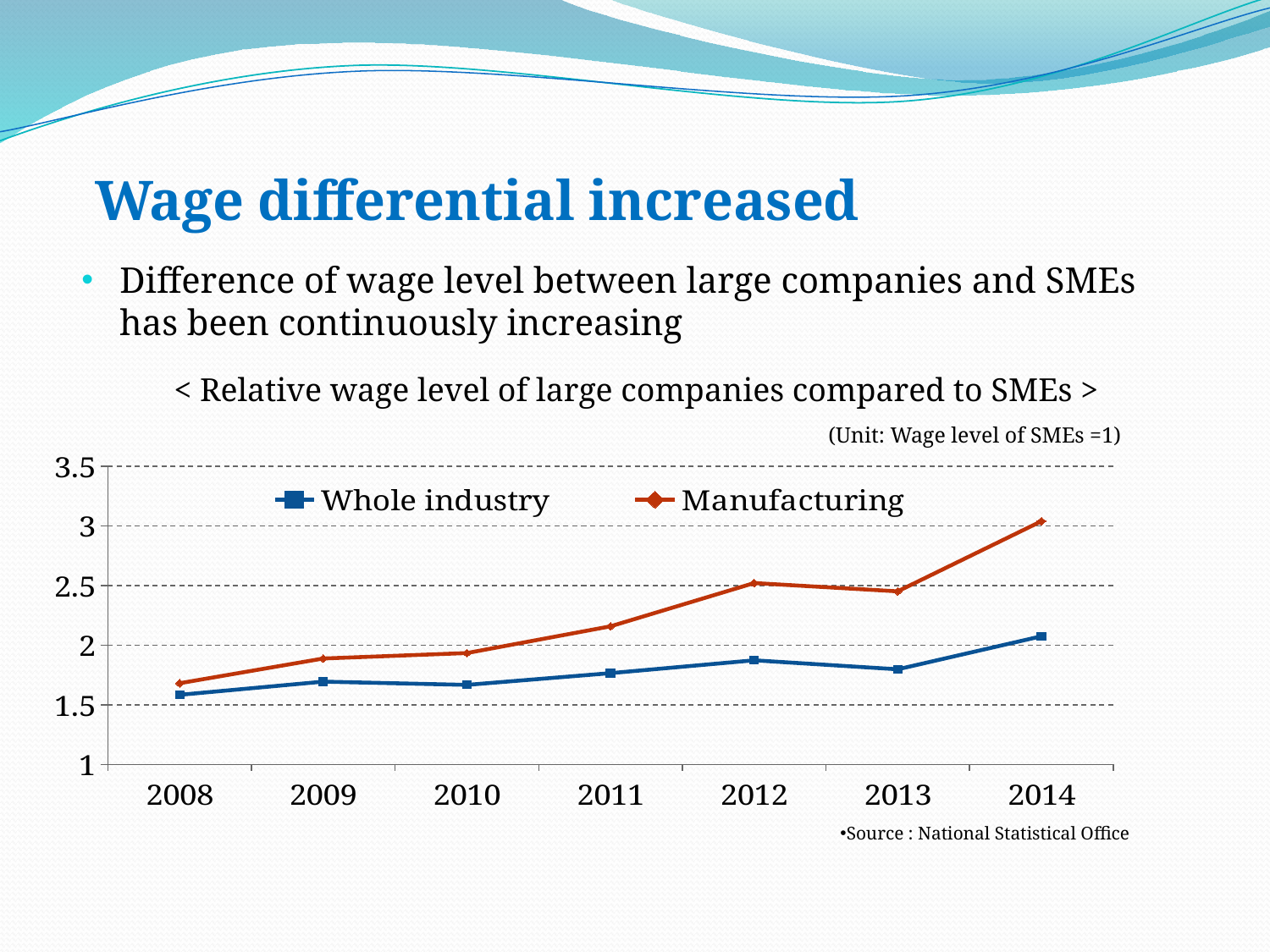
Overall, do the Manufacturing values rise or fall from 2008 to 2014? Rise In 2014, which series has the larger value, Whole industry or Manufacturing? Manufacturing Is the value for Manufacturing in 2008 greater or less than 2? less What kind of chart is shown on the slide? Line chart How many series does the chart legend list? 2 What is the title shown above the chart? Relative wage level of large companies compared to SMEs Is the value for Whole industry in 2012 greater or less than 2? less In which year is the Whole industry series at its lowest? 2008 In which year is the Manufacturing series at its highest? 2014 Is the value for Manufacturing in 2011 greater or less than 2? greater How many years are plotted along the x axis of the chart? 7